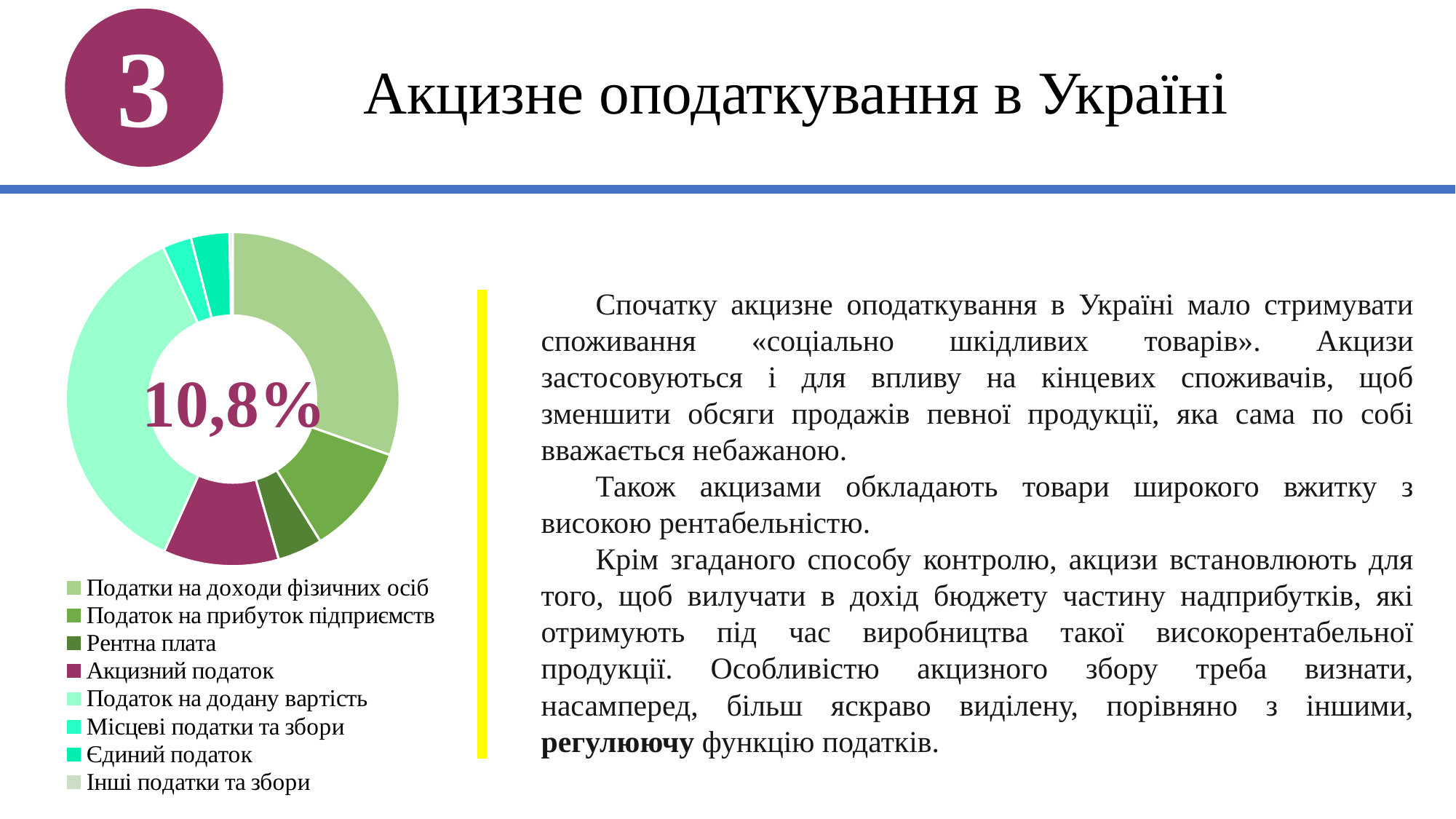
What percentage value is printed in the centre of the doughnut chart? 10,8% Which slice is larger: Податок на додану вартість or Єдиний податок? Податок на додану вартість How many categories does the legend of the doughnut chart list? 8 What kind of chart is shown on the slide? Doughnut (pie) chart Which slice is larger: Податки на доходи фізичних осіб or Акцизний податок? Податки на доходи фізичних осіб Which category has the largest slice in the doughnut chart? Податок на додану вартість What colour is the Акцизний податок slice in the doughnut chart? Magenta (purple-pink) Which slice is larger: Податок на додану вартість or Податки на доходи фізичних осіб? Податок на додану вартість Which legend entry is listed first in the doughnut chart's legend? Податки на доходи фізичних осіб